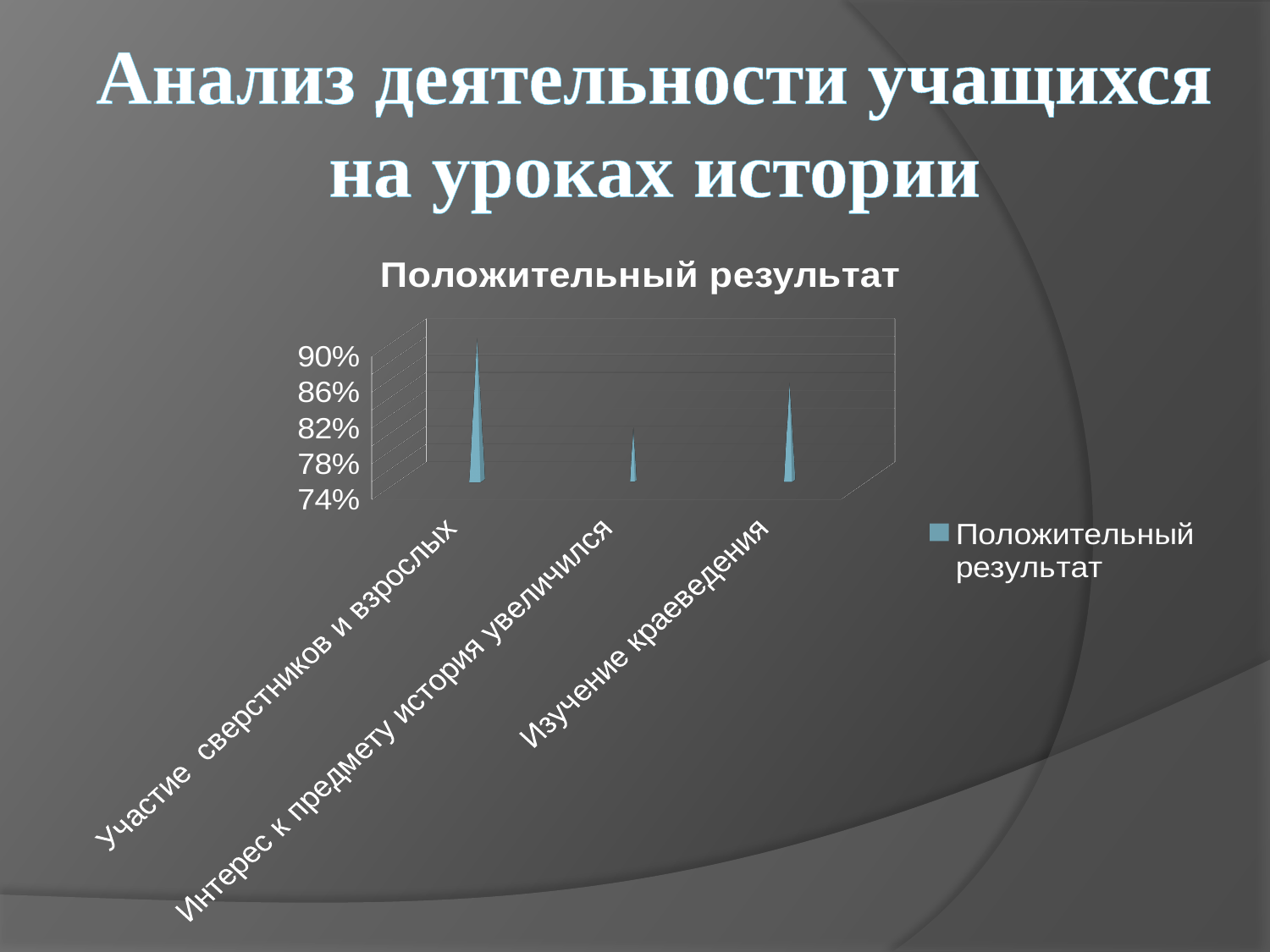
How many categories are plotted on the chart? 3 Is the value for Изучение краеведения greater or less than 82%? greater What kind of chart is shown on the slide? bar chart What is the title of the chart? Положительный результат What is the name of the series shown in the legend? Положительный результат Which is larger: the value for Участие сверстников и взрослых or the value for Интерес к предмету история увеличился? Участие сверстников и взрослых How many series does the legend list? 1 Which is larger: the value for Изучение краеведения or the value for Интерес к предмету история увеличился? Изучение краеведения Which category has the lowest value? Интерес к предмету история увеличился Is the value for Участие сверстников и взрослых greater or less than 86%? greater Which category has the highest value? Участие сверстников и взрослых Is the value for Интерес к предмету история увеличился greater or less than 82%? less